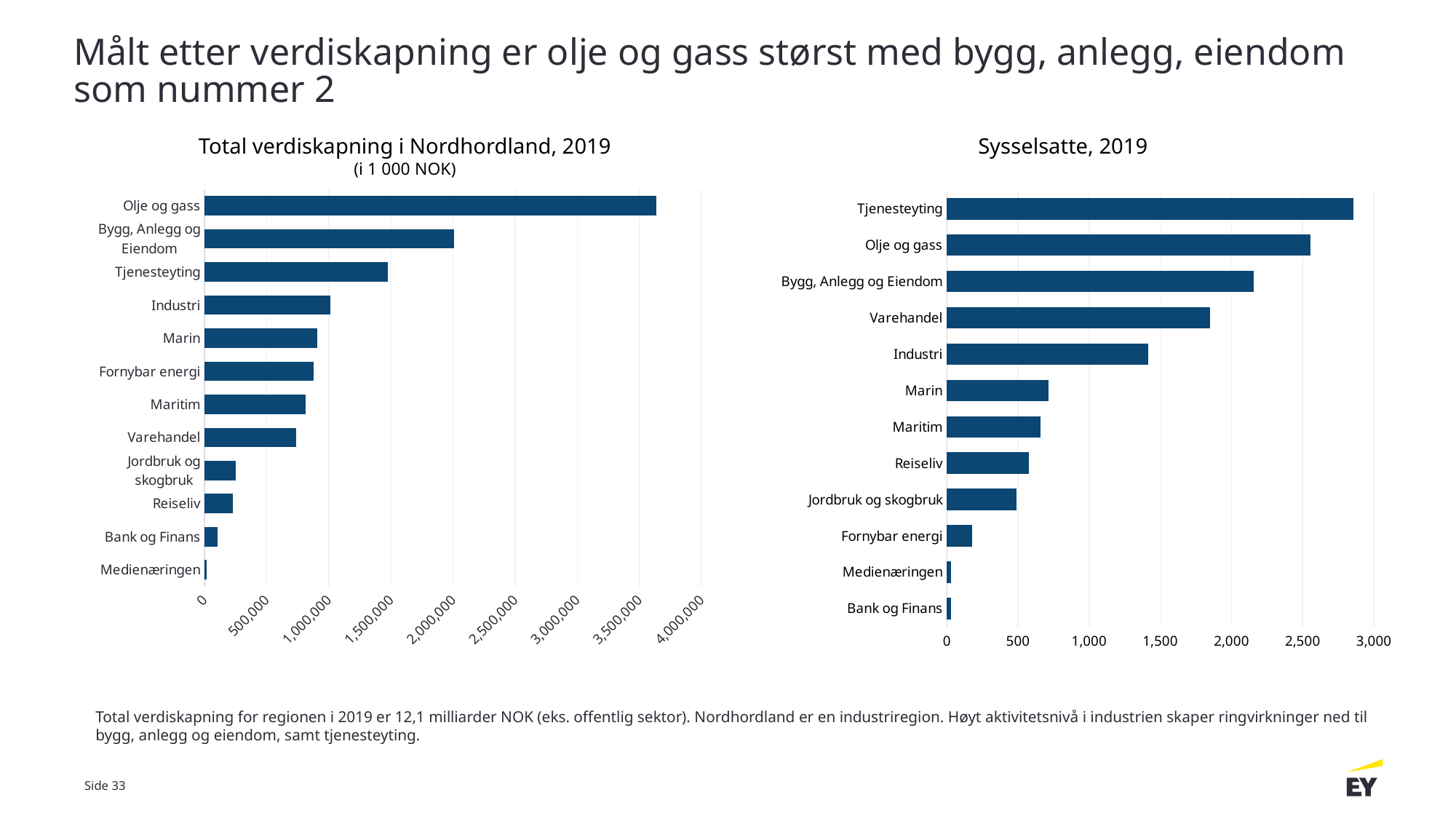
In the chart 'Total verdiskapning i Nordhordland, 2019', which is larger, Industri or Varehandel? Industri In the chart 'Sysselsatte, 2019', which category has the highest value? Tjenesteyting In the chart 'Total verdiskapning i Nordhordland, 2019', which category has the highest value? Olje og gass In the chart 'Total verdiskapning i Nordhordland, 2019', which category has the lowest value? Medienæringen What kind of chart is 'Total verdiskapning i Nordhordland, 2019'? Bar chart In the chart 'Sysselsatte, 2019', how many categories are shown? 12 In the chart 'Sysselsatte, 2019', which is larger, Varehandel or Industri? Varehandel What unit is given in the subtitle of the chart 'Total verdiskapning i Nordhordland, 2019'? i 1 000 NOK In the chart 'Total verdiskapning i Nordhordland, 2019', is the value for Olje og gass greater or less than 3,500,000? greater In the chart 'Total verdiskapning i Nordhordland, 2019', how many categories are shown? 12